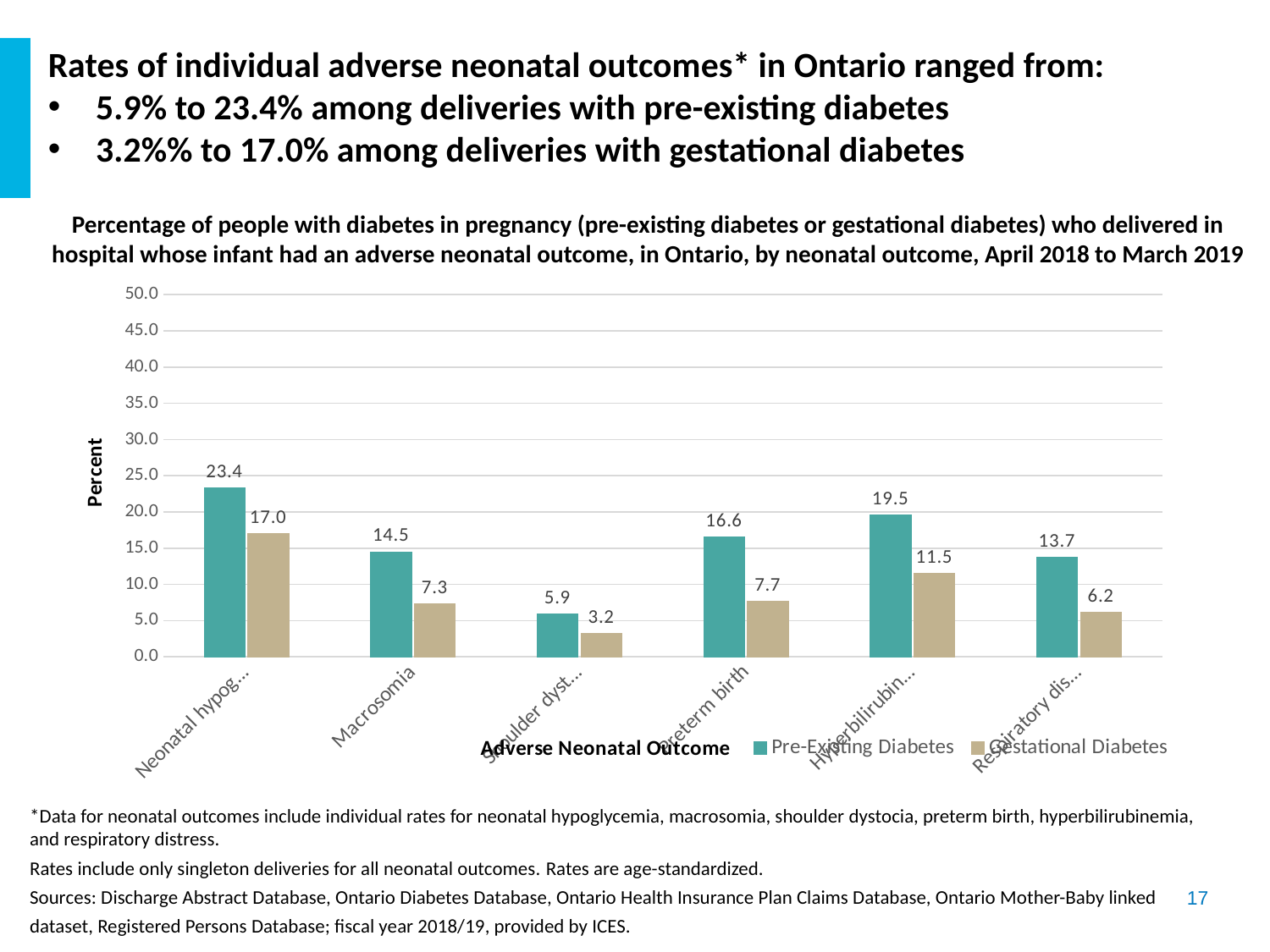
How many adverse neonatal outcome categories are plotted on the x axis? 6 What is the percentage for Macrosomia among deliveries with pre-existing diabetes? 14.5 What is the difference between the Pre-Existing Diabetes and Gestational Diabetes percentages for Preterm birth? 8.9 How many series does the legend list? 2 Which adverse neonatal outcome has the lowest percentage for the Gestational Diabetes series? Shoulder dystocia What is the label of the y axis? Percent What is the percentage for Macrosomia among deliveries with gestational diabetes? 7.3 For Macrosomia, which series has the larger percentage: Pre-Existing Diabetes or Gestational Diabetes? Pre-Existing Diabetes Which adverse neonatal outcome has the highest percentage for the Pre-Existing Diabetes series? Neonatal hypoglycemia What type of chart is shown on the slide? Bar chart What is the percentage for Preterm birth among deliveries with gestational diabetes? 7.7 Is the Pre-Existing Diabetes value for Preterm birth greater or less than 15.0? greater